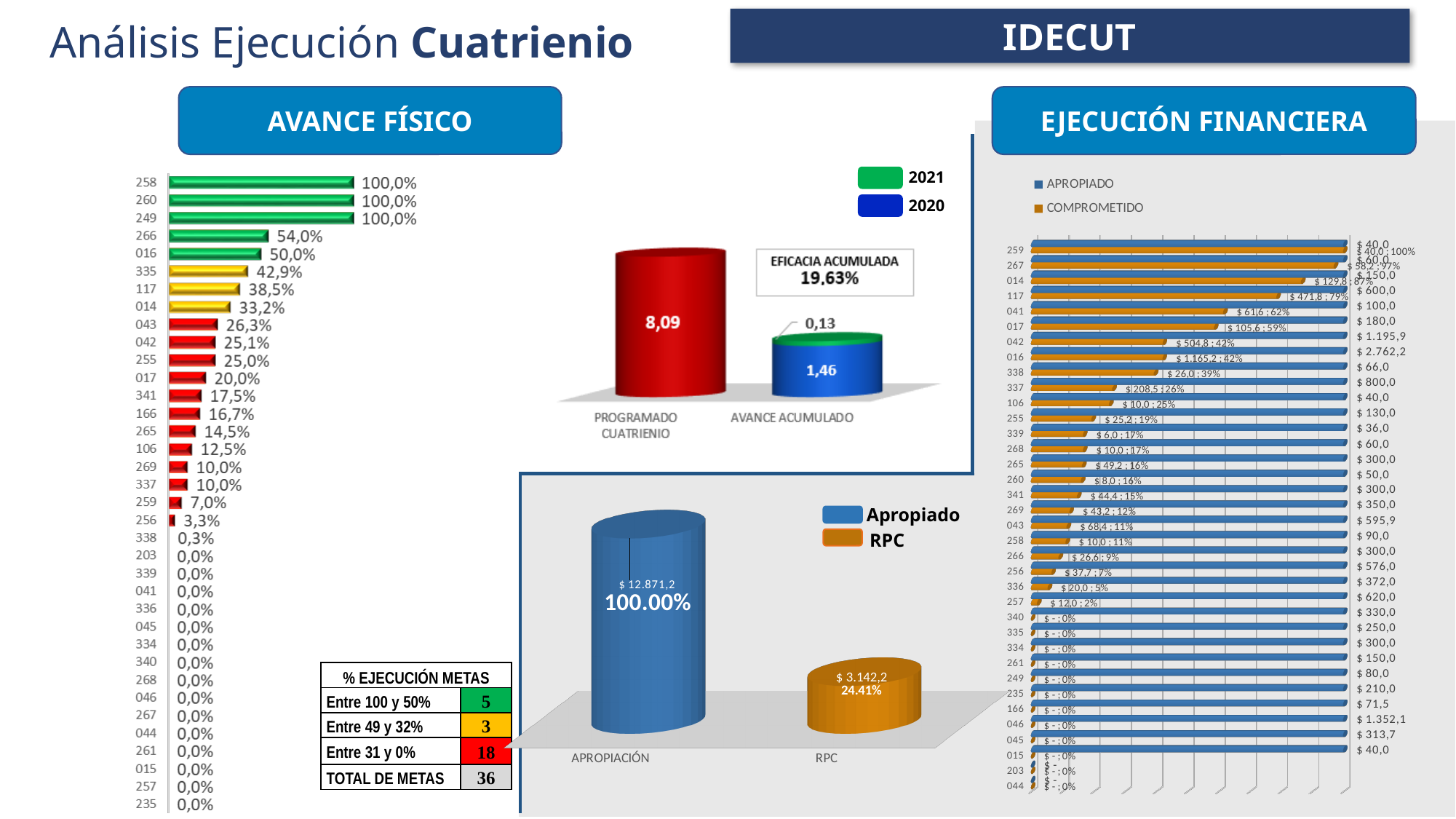
What kind of chart is the EJECUCIÓN FINANCIERA chart? bar chart In the AVANCE FÍSICO chart, how many categories are plotted? 36 In the AVANCE FÍSICO chart, what is the value for category 256? 3,3% In the EJECUCIÓN FINANCIERA chart, what is the APROPIADO value for category 117? $ 600,0 In the EJECUCIÓN FINANCIERA chart, which category has the highest APROPIADO value? 016 In the APROPIACIÓN / RPC chart, what is the value shown for RPC? $ 3.142,2 In the PROGRAMADO CUATRIENIO / AVANCE ACUMULADO chart, what is the value for PROGRAMADO CUATRIENIO? 8,09 In the AVANCE FÍSICO chart, which is larger, the value for 335 or the value for 117? 335 In the AVANCE FÍSICO chart, what is the value for category 043? 26,3% In the PROGRAMADO CUATRIENIO / AVANCE ACUMULADO chart, how many series does the legend list? 2 In the AVANCE FÍSICO chart, what is the value for category 266? 54,0% In the PROGRAMADO CUATRIENIO / AVANCE ACUMULADO chart, what is the difference between PROGRAMADO CUATRIENIO (8,09) and the 2020 AVANCE ACUMULADO value (1,46)? 6,63